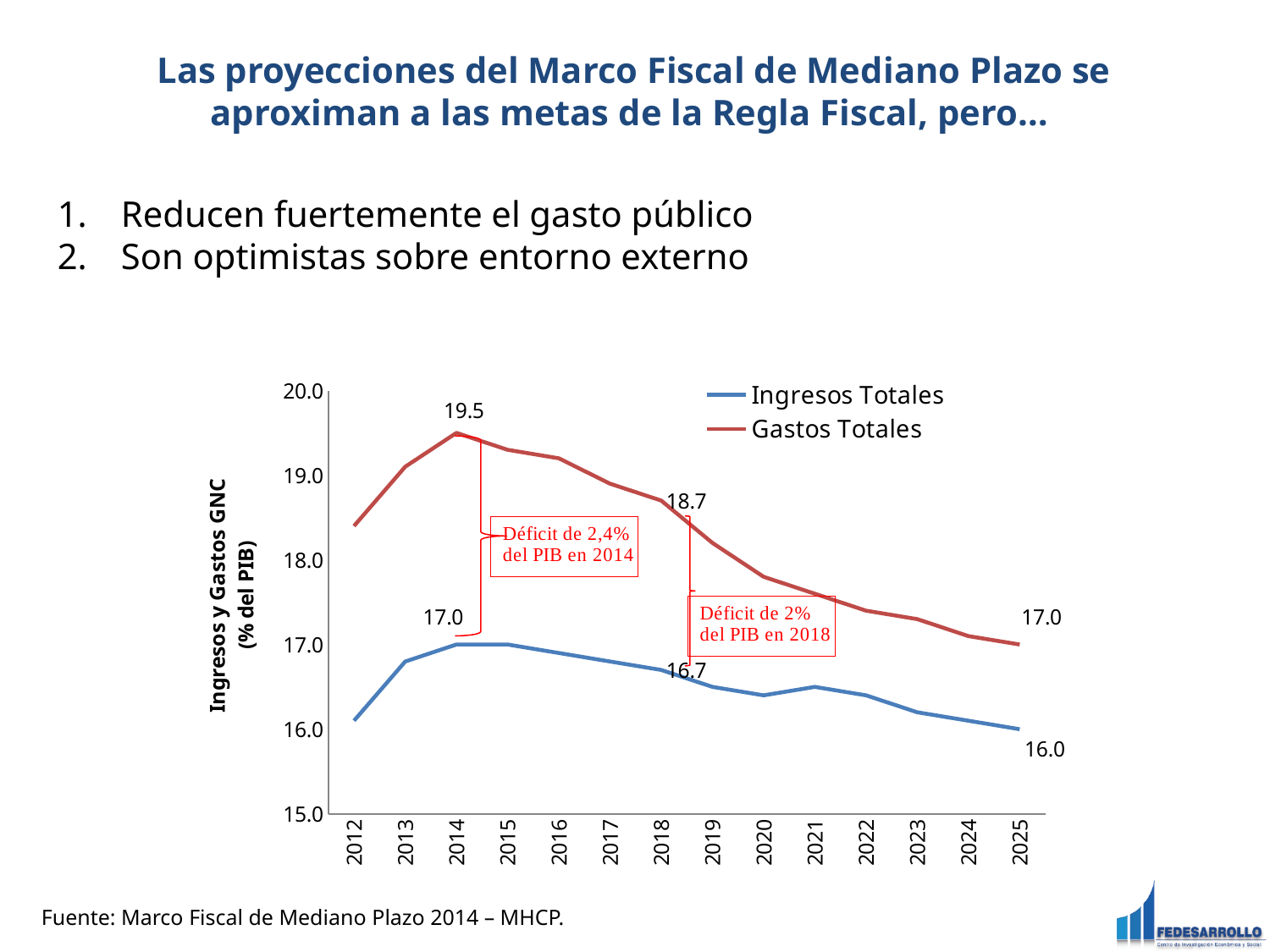
What is the value of Ingresos Totales in 2025? 16.0 Is the value of Ingresos Totales in 2012 greater or less than 17.0? less How many years are shown on the x axis of the chart? 14 What is the difference between Gastos Totales and Ingresos Totales in 2018? 2.0 What is the value of Ingresos Totales in 2014? 17.0 Does Gastos Totales rise or fall between 2014 and 2025? fall How many series does the chart legend list? 2 What type of chart is shown on the slide? line chart What is the value of Gastos Totales in 2014? 19.5 What are the two series named in the chart legend? Ingresos Totales and Gastos Totales Which series is higher in 2020, Ingresos Totales or Gastos Totales? Gastos Totales What is the value of Gastos Totales in 2018? 18.7